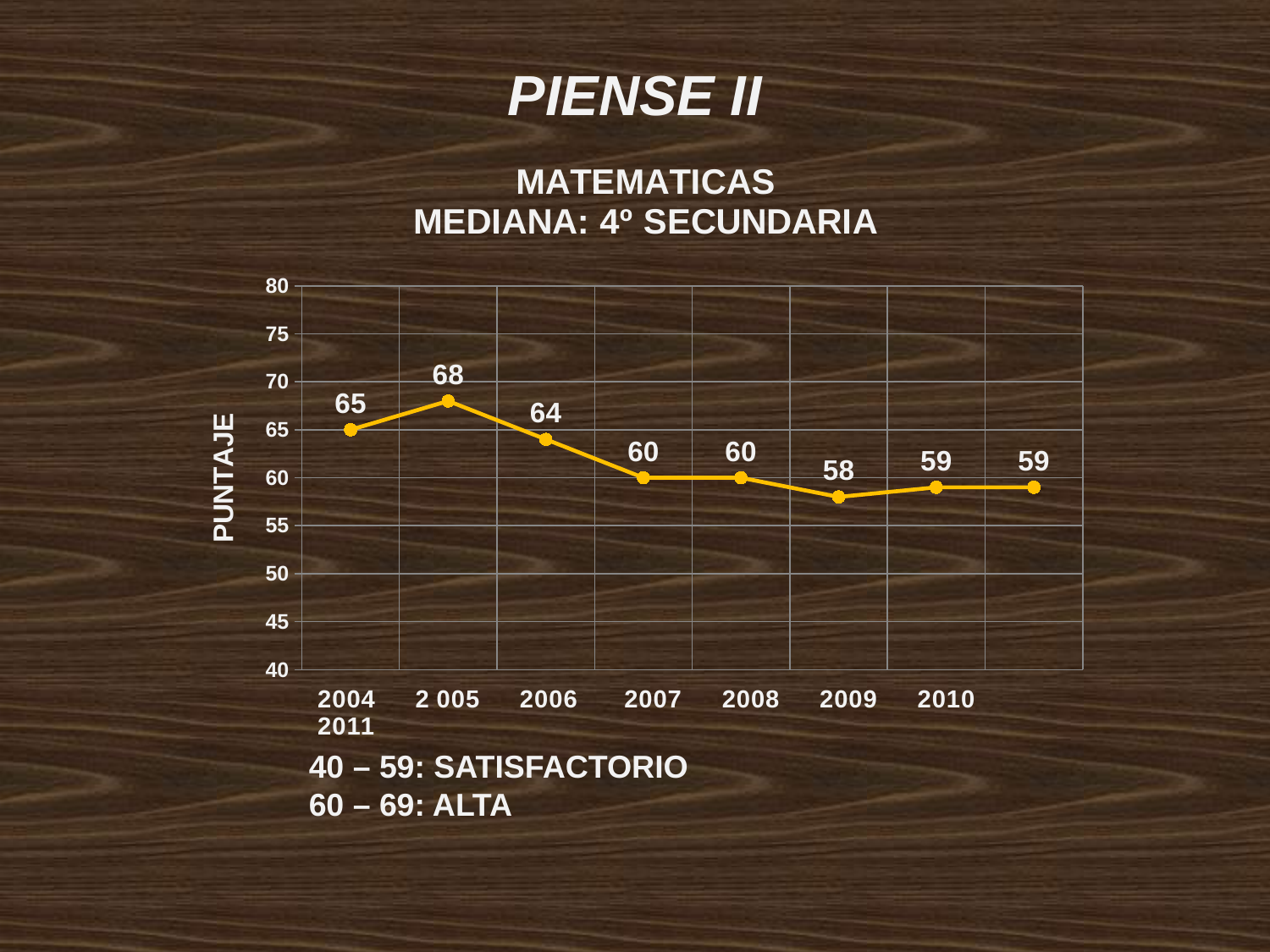
Which year has the highest PUNTAJE value? 2005 What is the label on the vertical axis of the chart? PUNTAJE What is the difference between the 2004 value and the 2006 value? 1 What is the difference between the 2005 value and the 2009 value? 10 How many data points are plotted on the line? 8 What is the value plotted for 2006? 64 Overall, do the values rise or fall from 2005 to 2009? fall Which year has the lowest PUNTAJE value? 2009 Which is larger, the value for 2006 or the value for 2010? 2006 What type of chart is shown on the slide? line chart What is the value plotted for 2009? 58 What is the median mathematics score (PUNTAJE) for 2004? 65